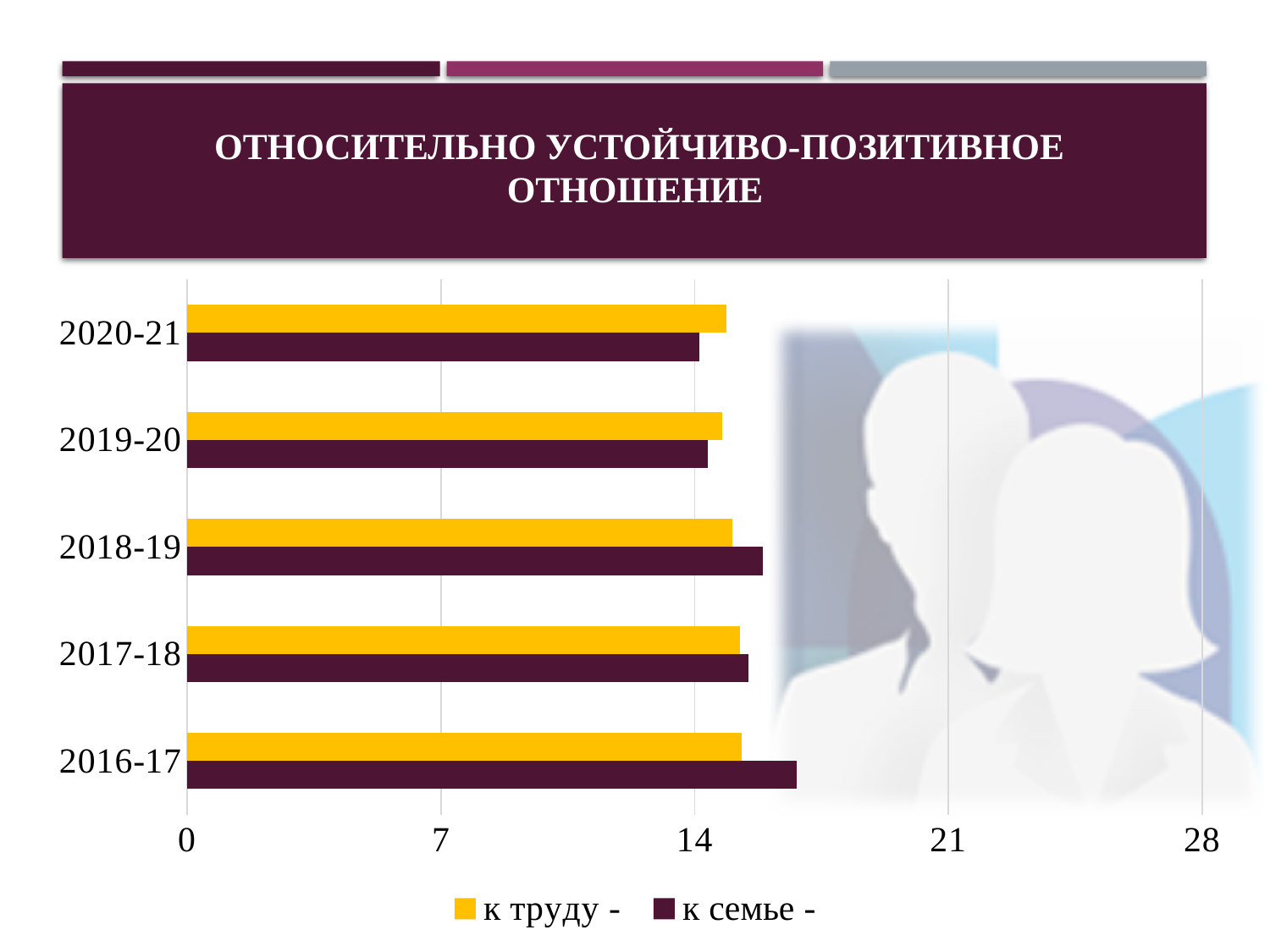
What kind of chart is shown on the slide? bar chart For the 'к семье -' series, which year has the highest value? 2016-17 In 2020-21, which series has the larger value, 'к труду -' or 'к семье -'? к труду - Is the value for 'к труду -' in 2020-21 greater or less than 14? greater Is the value for 'к семье -' in 2019-20 greater or less than 21? less Is the value for 'к семье -' in 2016-17 greater or less than 14? greater How many categories (academic years) are shown on the chart? 5 What are the two series named in the legend? к труду - and к семье - What is the title of the slide above the chart? ОТНОСИТЕЛЬНО УСТОЙЧИВО-ПОЗИТИВНОЕ ОТНОШЕНИЕ How many series does the legend list? 2 In 2016-17, which series has the larger value, 'к труду -' or 'к семье -'? к семье -